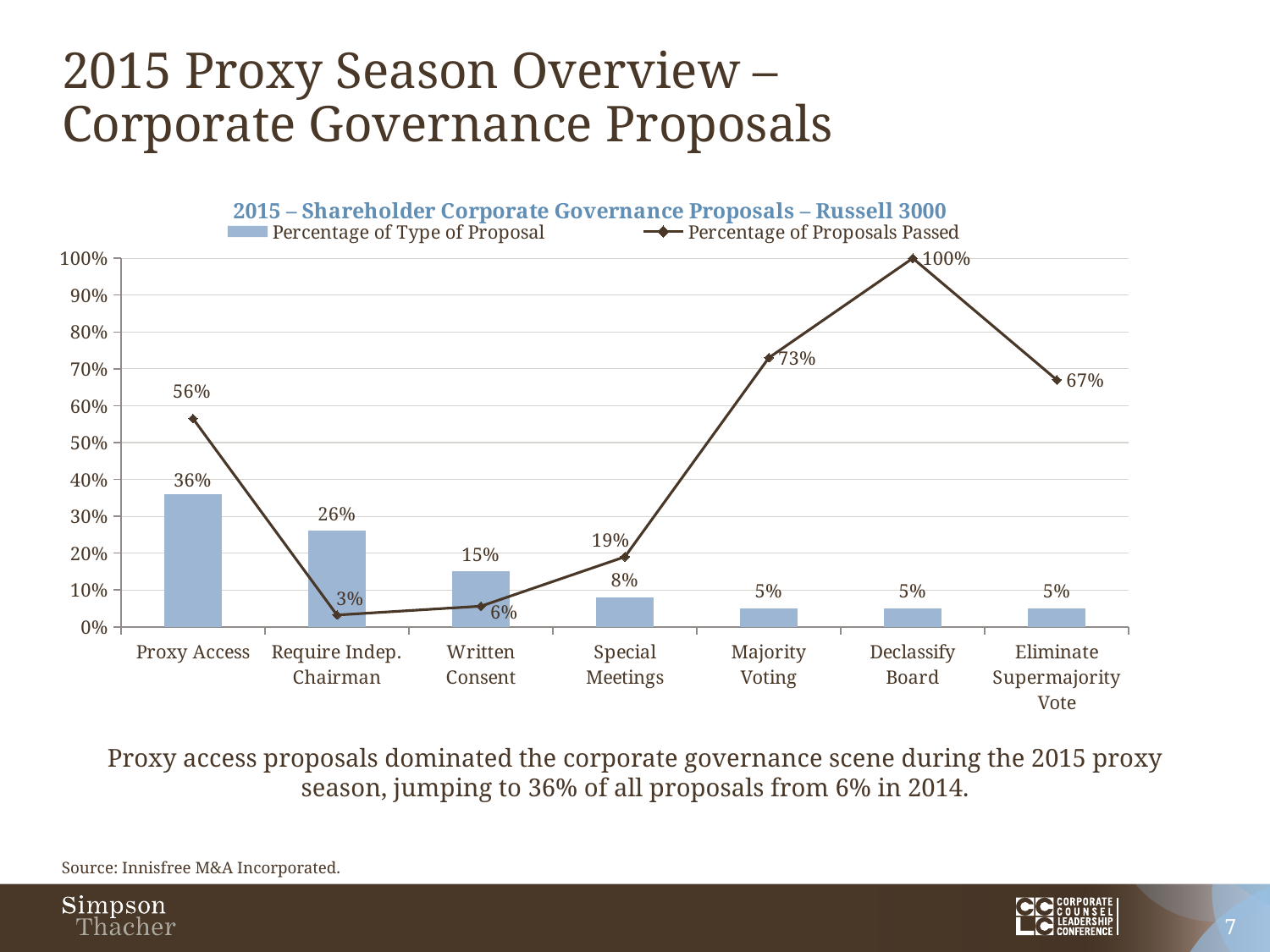
What is the difference between the Percentage of Proposals Passed for Majority Voting and for Eliminate Supermajority Vote? 6% What kind of chart is this? Combined bar and line chart Which category has the lowest Percentage of Proposals Passed? Require Indep. Chairman What is the Percentage of Proposals Passed for Declassify Board? 100% What is the Percentage of Proposals Passed for Require Indep. Chairman? 3% How many proposal categories are shown on the x axis? 7 Which is larger: the Percentage of Proposals Passed for Proxy Access or for Written Consent? Proxy Access What is the Percentage of Type of Proposal for Proxy Access? 36% Which category has the highest Percentage of Type of Proposal? Proxy Access Which category has the highest Percentage of Proposals Passed? Declassify Board How many series does the legend list? 2 What is the Percentage of Type of Proposal for Special Meetings? 8%